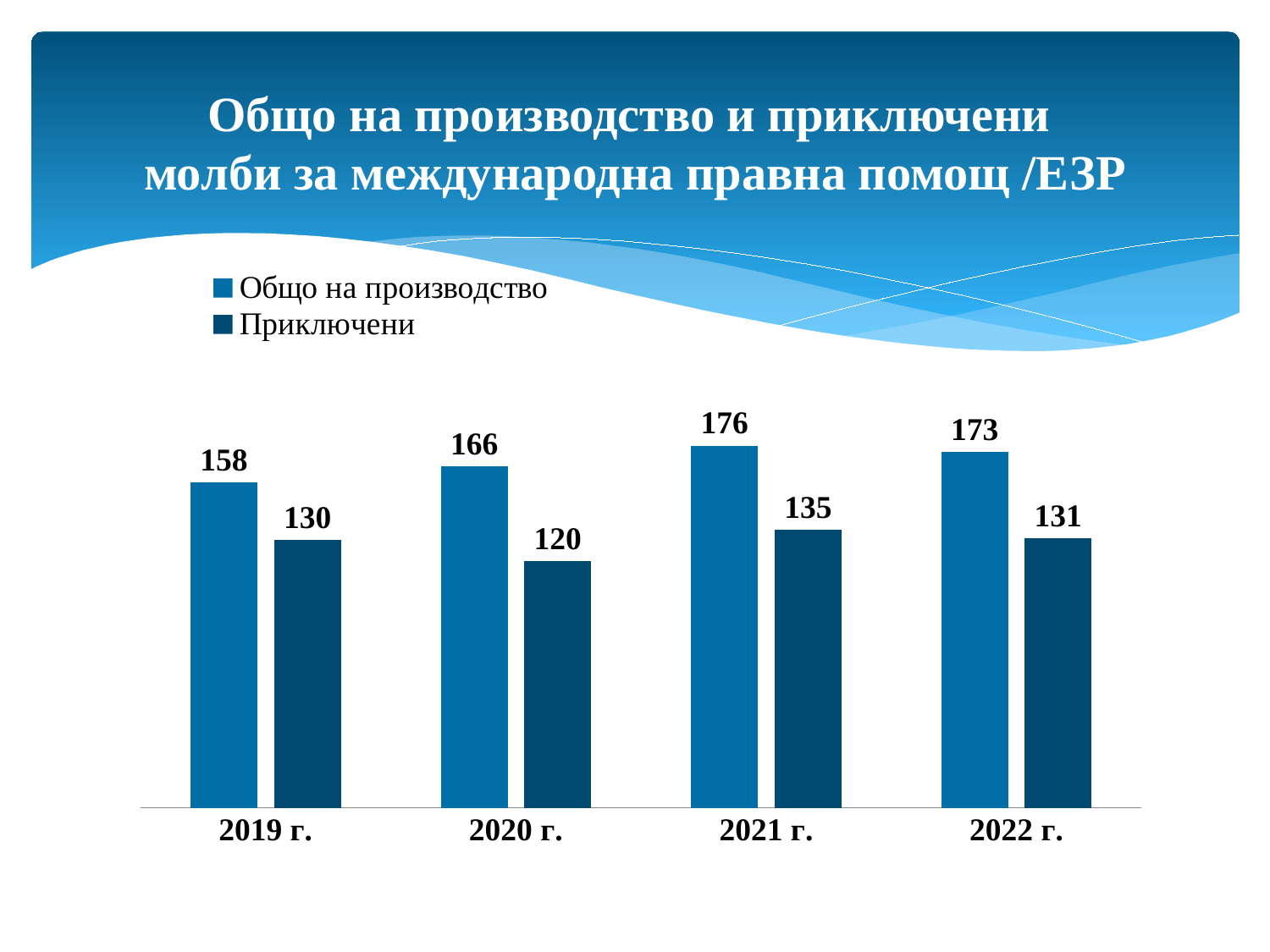
How many series does the legend list? 2 What is the value of "Общо на производство" for 2021 г.? 176 Which year has the lowest value for "Приключени"? 2020 г. Does the "Общо на производство" series rise or fall from 2019 г. to 2021 г.? Rise Which year has the highest value for "Общо на производство"? 2021 г. What is the value of "Приключени" for 2020 г.? 120 What kind of chart is shown on the slide? Bar chart Which is larger: "Приключени" in 2021 г. or "Приключени" in 2022 г.? 2021 г. How many years are shown on the x axis? 4 What is the difference between the "Общо на производство" values for 2020 г. and 2019 г.? 8 What is the difference between "Общо на производство" and "Приключени" in 2019 г.? 28 What is the value of "Приключени" for 2022 г.? 131